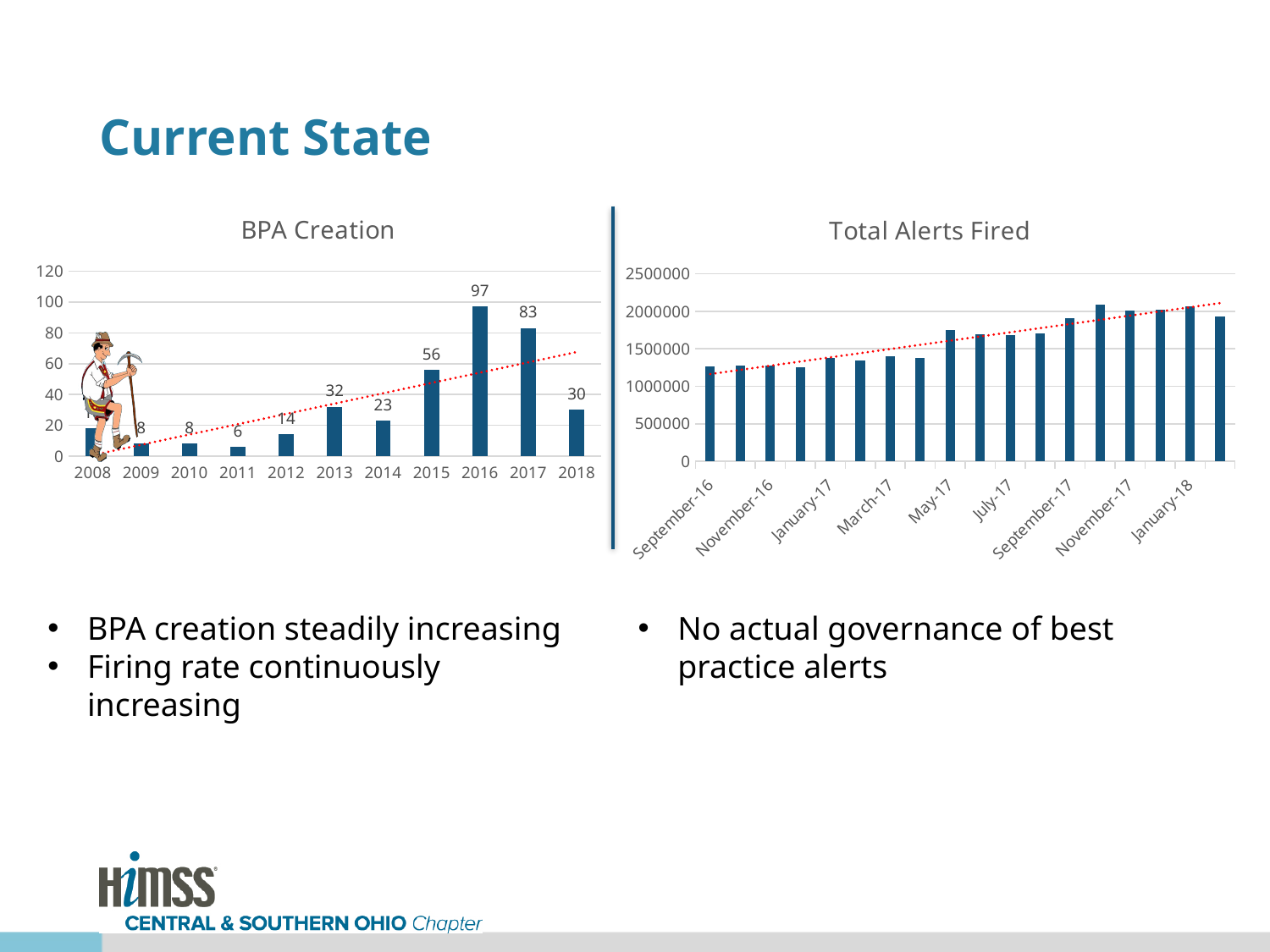
How many years are shown on the x axis of the BPA Creation chart? 11 In the BPA Creation chart, which year has the highest value? 2016 In the BPA Creation chart, which year has the larger value, 2015 or 2018? 2015 In the BPA Creation chart, what is the difference between the values for 2017 and 2018? 53 In the BPA Creation chart, which year has the lowest value? 2011 In the Total Alerts Fired chart, is the value for September-16 greater or less than 1500000? less In the BPA Creation chart, what is the value for 2013? 32 In the BPA Creation chart, what is the value for 2016? 97 In the BPA Creation chart, what is the difference between the values for 2016 and 2017? 14 What kind of chart is the BPA Creation chart? Bar chart In the Total Alerts Fired chart, do the values generally rise or fall from September-16 to January-18? rise